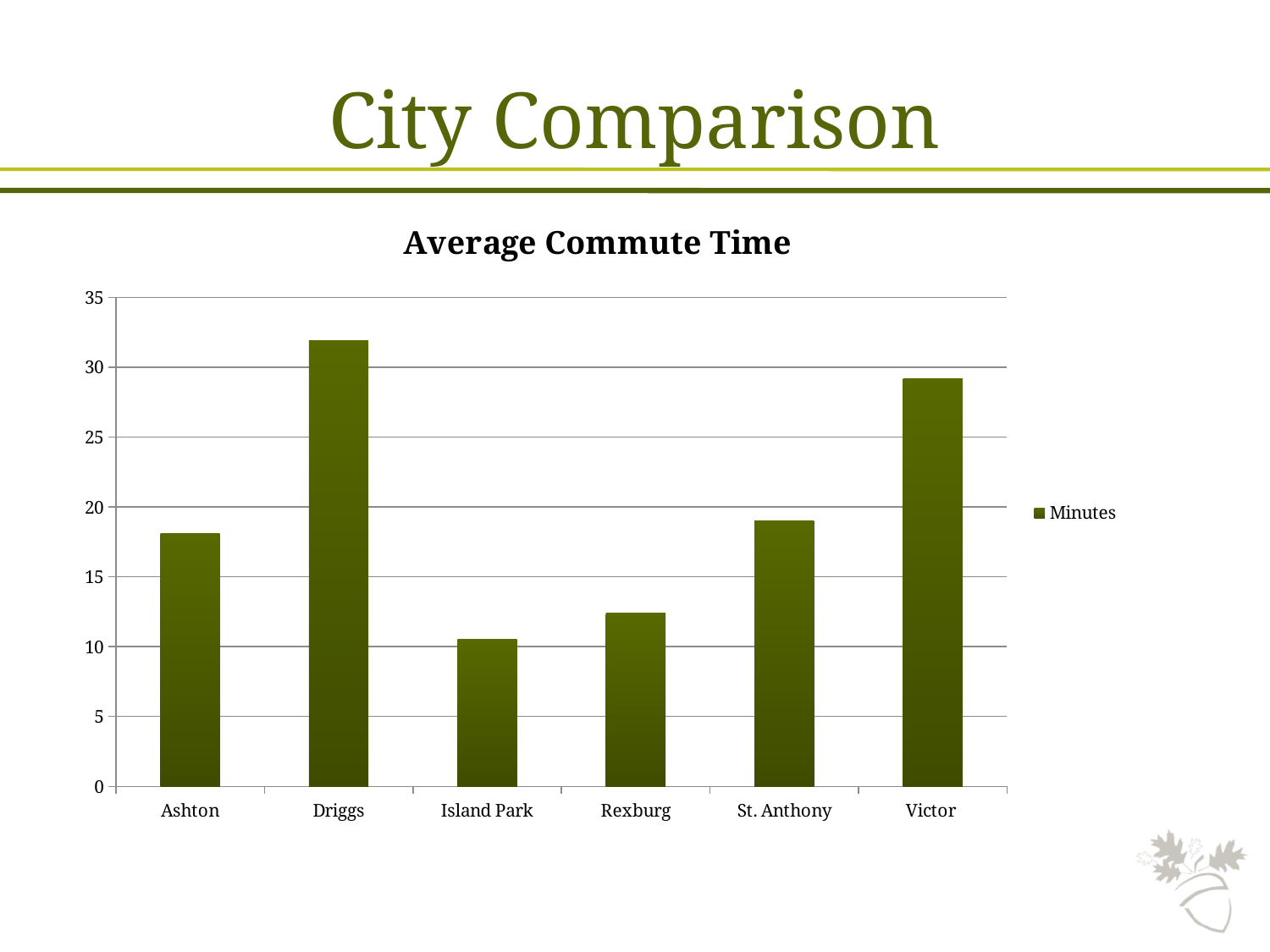
Which city has a higher average commute time, Driggs or Victor? Driggs Is the value for Rexburg greater or less than 15? less Is the value for Victor greater or less than 30? less Which city has the lowest average commute time? Island Park What is the title of the chart? Average Commute Time What type of chart is shown on the slide? bar chart How many cities are shown on the x axis of the chart? 6 Is the value for Driggs greater or less than 30? greater How many series does the legend list? 1 Which city has the highest average commute time? Driggs What is the name of the series shown in the legend? Minutes Which city has a higher average commute time, Island Park or Rexburg? Rexburg